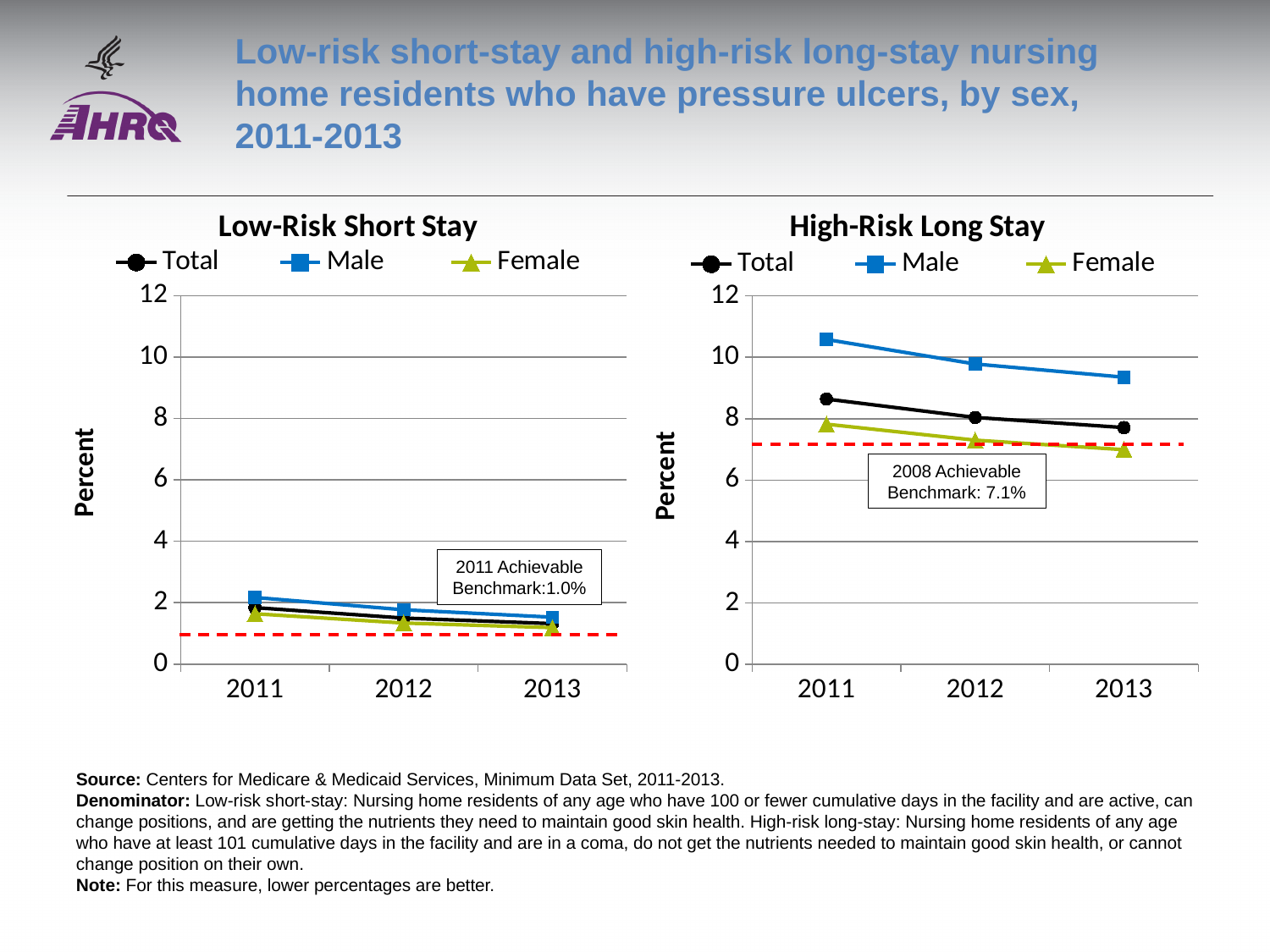
How many series does the legend of the High-Risk Long Stay chart list? 3 In the High-Risk Long Stay chart, do the Male values rise or fall from 2011 to 2013? fall How many years are plotted on the x axis of the Low-Risk Short Stay chart? 3 In the Low-Risk Short Stay chart, is the Female value for 2011 greater or less than 2? less In the High-Risk Long Stay chart, is the Male value for 2013 greater or less than 10? less In the Low-Risk Short Stay chart, do the Total values rise or fall from 2011 to 2013? fall In the High-Risk Long Stay chart, is the Total value for 2011 greater or less than 8? greater What achievable benchmark is shown on the High-Risk Long Stay chart? 2008 Achievable Benchmark: 7.1% In the High-Risk Long Stay chart, which is larger in 2013, the Male value or the Female value? Male What kind of chart is the Low-Risk Short Stay chart? line chart In the High-Risk Long Stay chart, which series has the highest value in 2011? Male